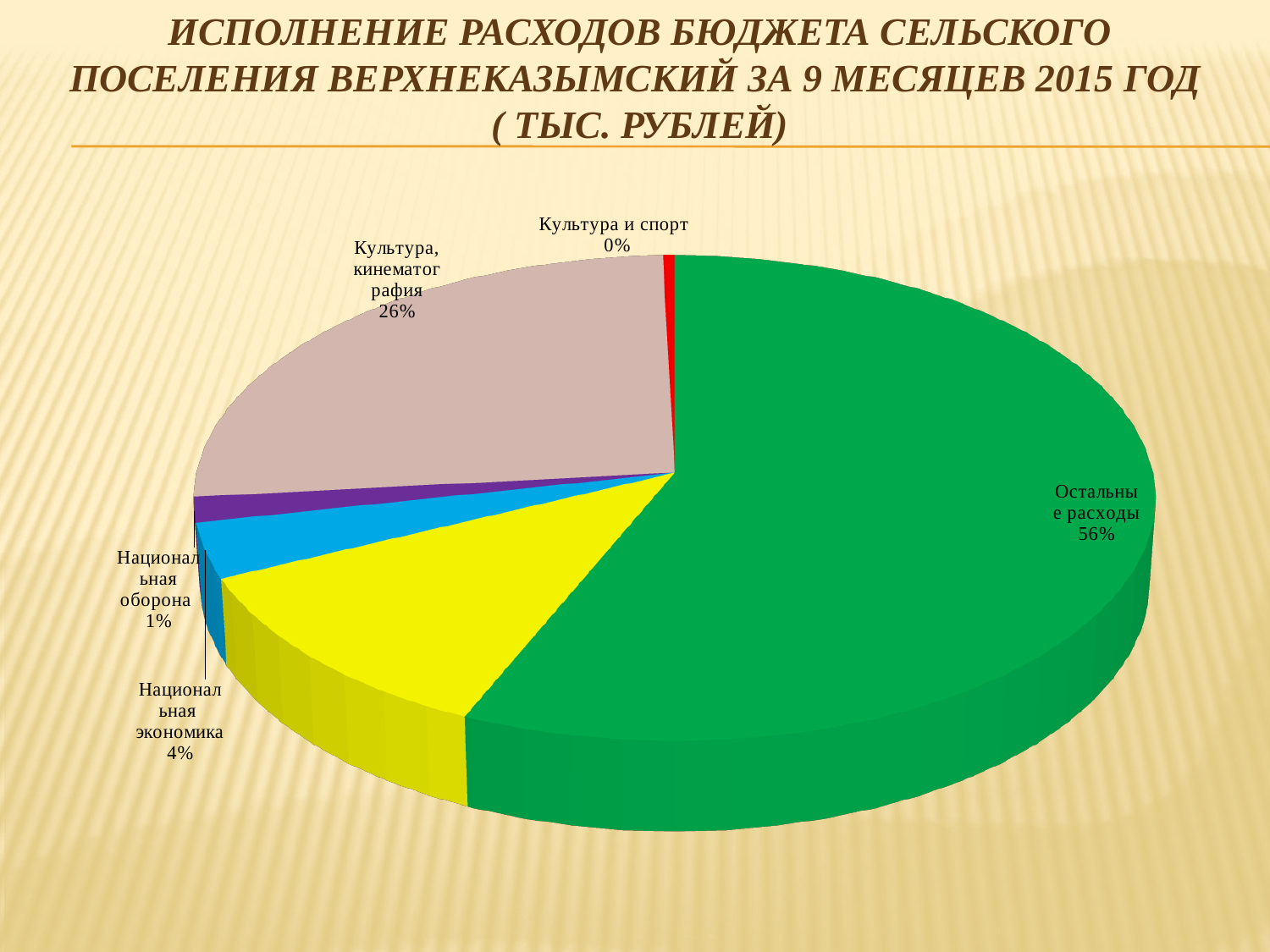
What percentage is shown for "Национальная оборона"? 1% Which labelled category has the smallest share of the pie? Культура и спорт Which labelled category has the largest share of the pie? Остальные расходы By how many percentage points does "Остальные расходы" exceed "Культура, кинематография"? 30 percentage points What percentage is shown for "Культура, кинематография"? 26% Which is larger: the share for "Культура, кинематография" or for "Национальная экономика"? Культура, кинематография What kind of chart is shown on the slide? Pie chart What colour is the slice for "Остальные расходы"? Green What share of expenditures is labelled for "Остальные расходы"? 56% By how many percentage points does "Культура, кинематография" exceed "Национальная экономика"? 22 percentage points What percentage is shown for "Национальная экономика"? 4% What percentage is shown for "Культура и спорт"? 0%